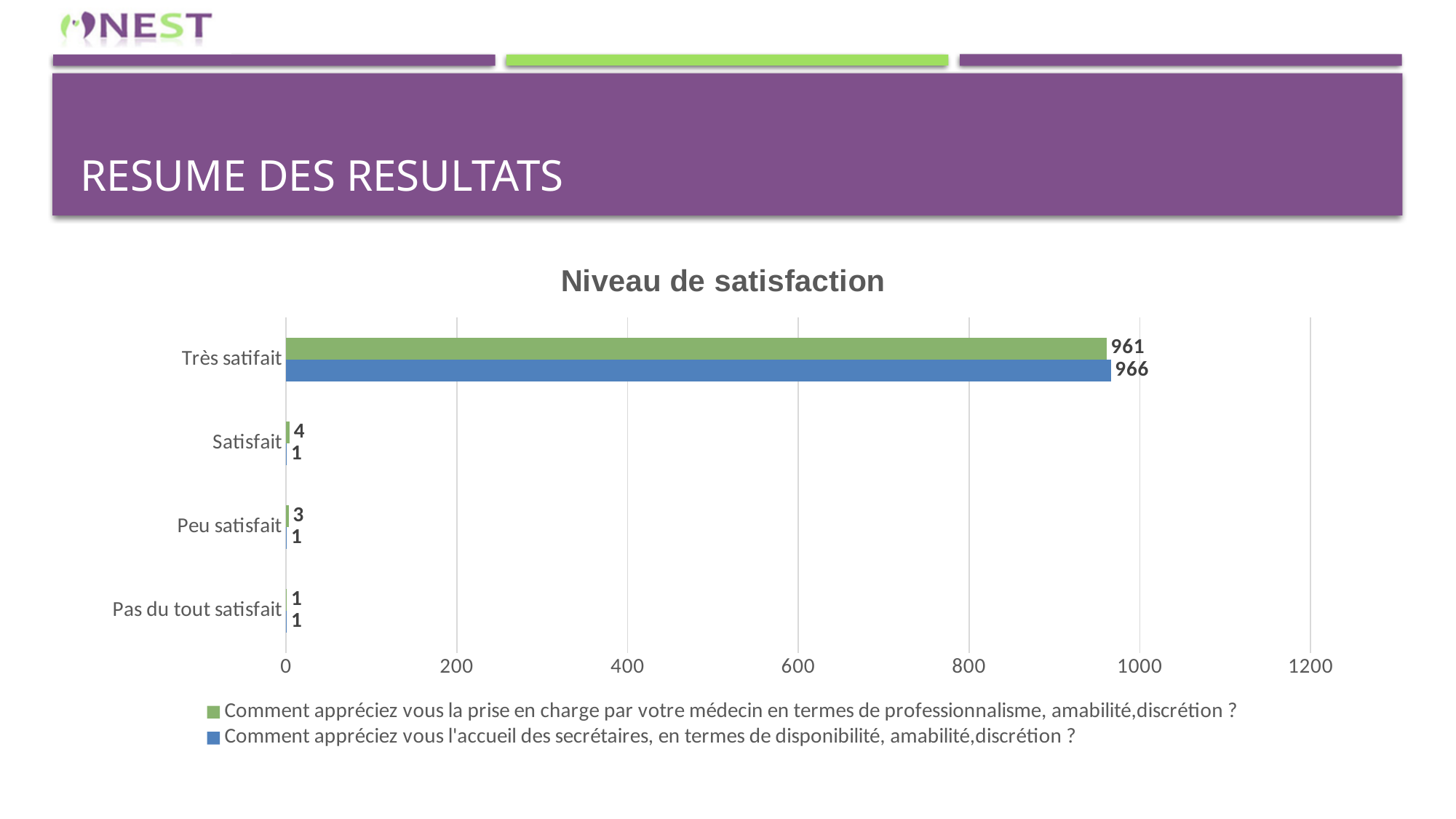
What is the value for 'Très satifait' in the series about the secrétaires (blue)? 966 What is the difference between the two series' values for 'Très satifait'? 5 How many categories are shown on the chart? 4 What is the title of the chart? Niveau de satisfaction What is the difference between 'Satisfait' and 'Peu satisfait' in the series about the médecin (green)? 1 What is the value for 'Satisfait' in the series about the médecin (green)? 4 How many series does the legend list? 2 What kind of chart is shown? bar chart What is the value for 'Très satifait' in the series about the médecin (green)? 961 What is the value for 'Peu satisfait' in the series about the secrétaires (blue)? 1 For 'Très satifait', which series has the larger value: the médecin (green) or the secrétaires (blue)? secrétaires (blue) Which category has the highest value in the series about the médecin (green)? Très satifait